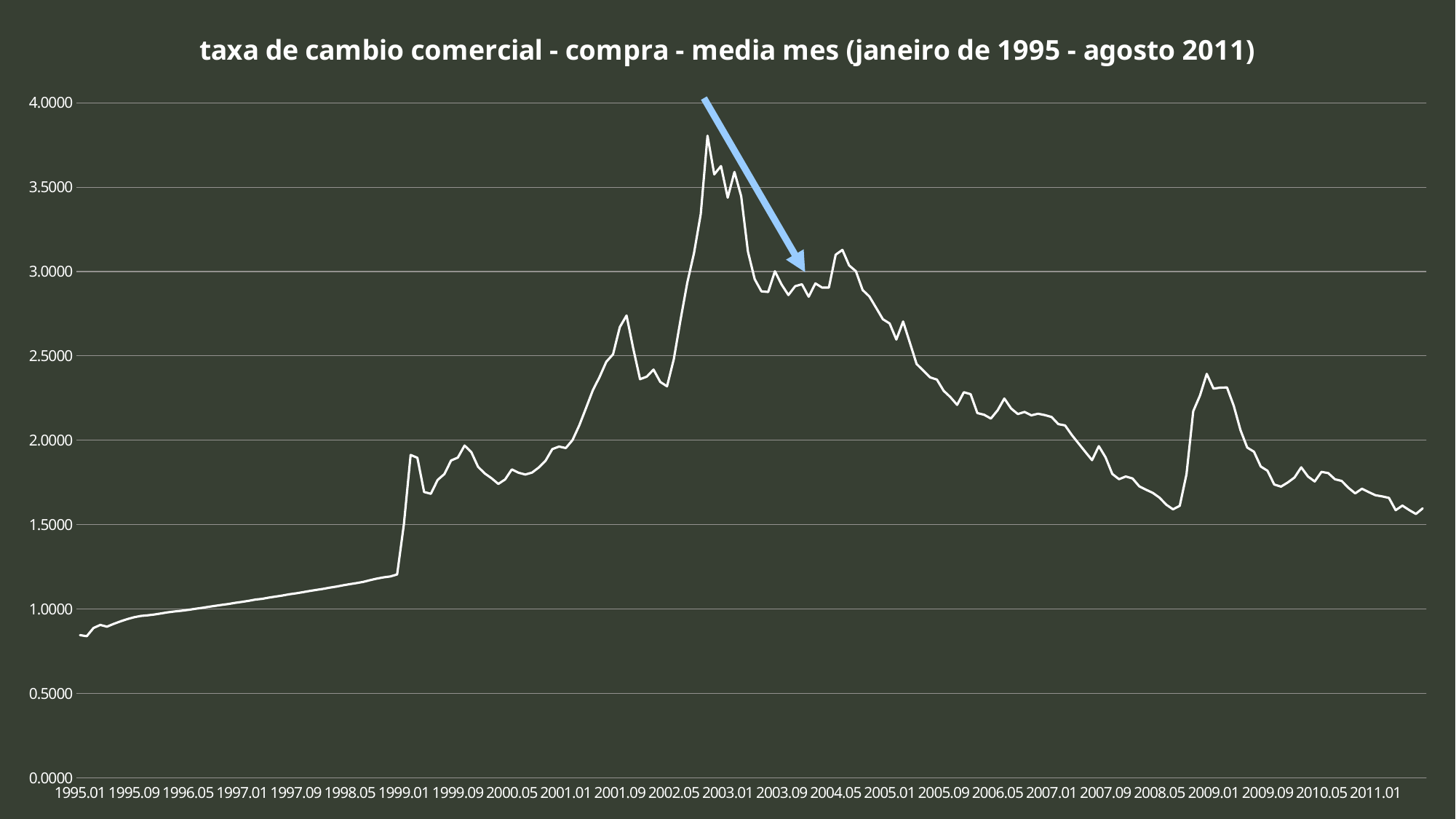
In which year does the line reach its highest value? 2002 What is the title of the chart? taxa de cambio comercial - compra - media mes (janeiro de 1995 - agosto 2011) Is the value for 2008.05 greater or less than 2.0000? less Does the line rise or fall between 2005.01 and 2007.09? fall Is the value for 2005.01 greater or less than 2.5000? greater Does the line rise or fall between 1995.01 and 1999.01? rise Is the value for 1995.01 greater or less than 1.0000? less What kind of chart is shown on the slide? line chart